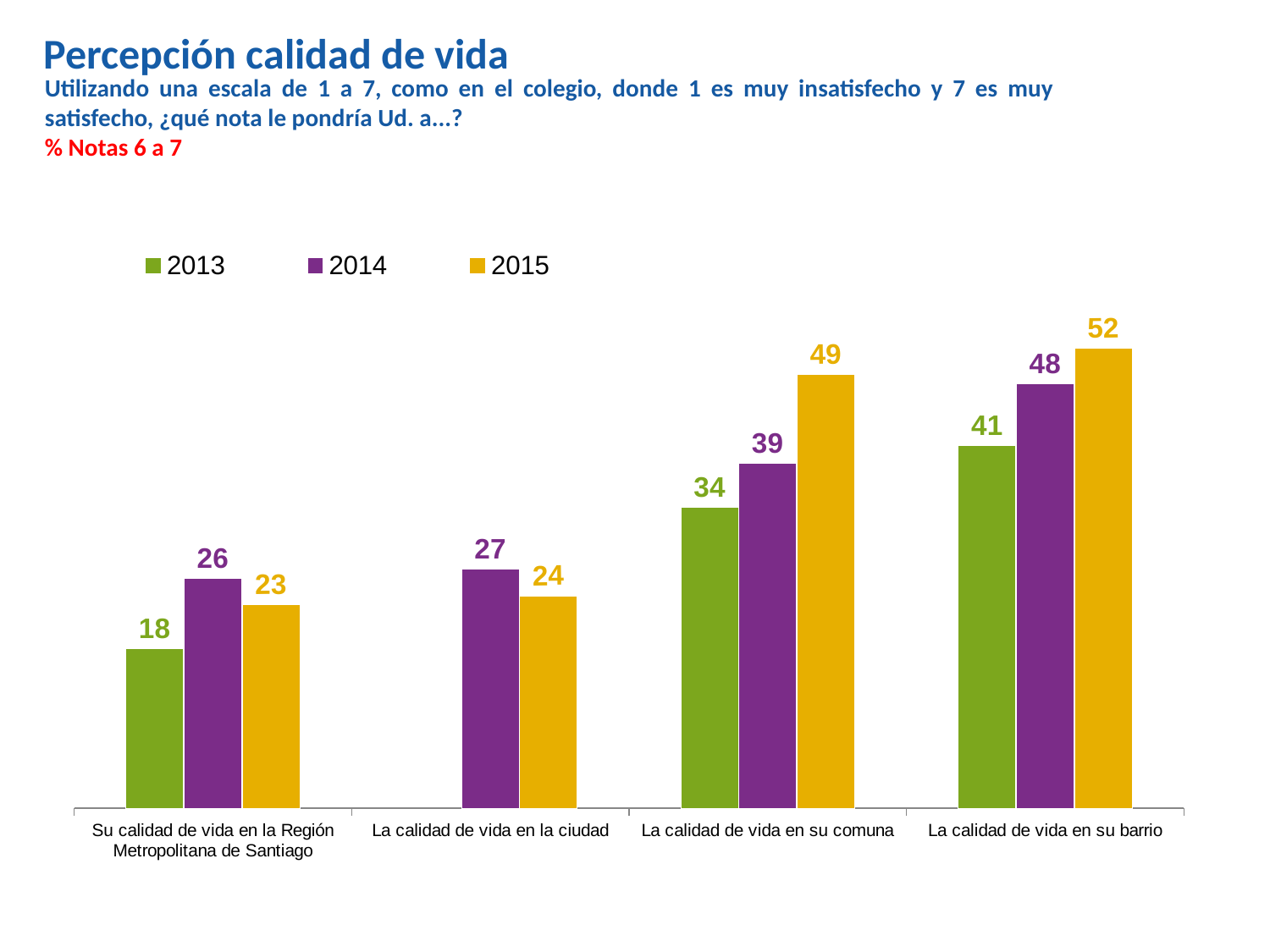
What is the difference between the 2015 and 2013 values for 'La calidad de vida en su comuna'? 15 What is the 2014 value for 'La calidad de vida en la ciudad'? 27 What kind of chart is shown on the slide? Bar chart Which category has the lowest 2013 value? Su calidad de vida en la Región Metropolitana de Santiago What is the 2015 value for 'La calidad de vida en su barrio'? 52 Which category has the highest 2015 value? La calidad de vida en su barrio How many categories are shown on the x axis? 4 For 'La calidad de vida en la ciudad', which is larger: the 2014 value or the 2015 value? 2014 Do the 2015 values rise or fall from left to right across the categories? Rise Which colour represents the 2014 series in the legend? Purple What is the 2013 value for 'Su calidad de vida en la Región Metropolitana de Santiago'? 18 How many series does the legend list? 3